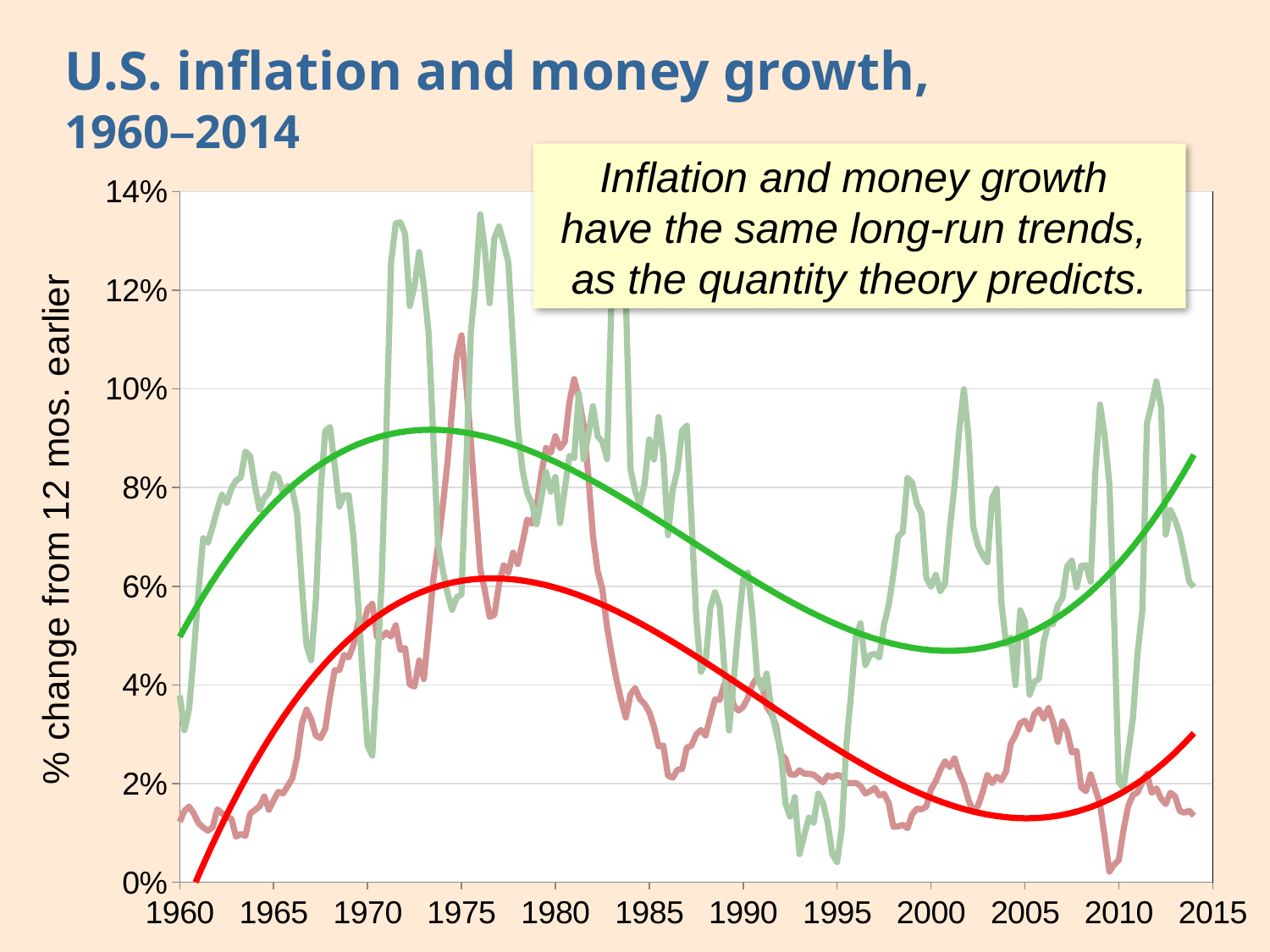
What is the highest value shown on the vertical axis of the chart? 14% Is the peak of the jagged light green line around 1972 greater or less than 12%? greater Is the highest point of the smooth green trend line, around 1973, greater or less than 8%? greater What is the title of the chart on the slide? U.S. inflation and money growth, 1960–2014 What is the last year labelled on the horizontal axis of the chart? 2015 What is the first year labelled on the horizontal axis of the chart? 1960 How many lines are plotted on the chart? 4 Is the peak of the jagged light red line around 1975 greater or less than 10%? greater What kind of chart is shown on the slide? line chart What is the label on the vertical axis of the chart? % change from 12 mos. earlier Does the smooth green trend line rise or fall between 1975 and 2000? fall